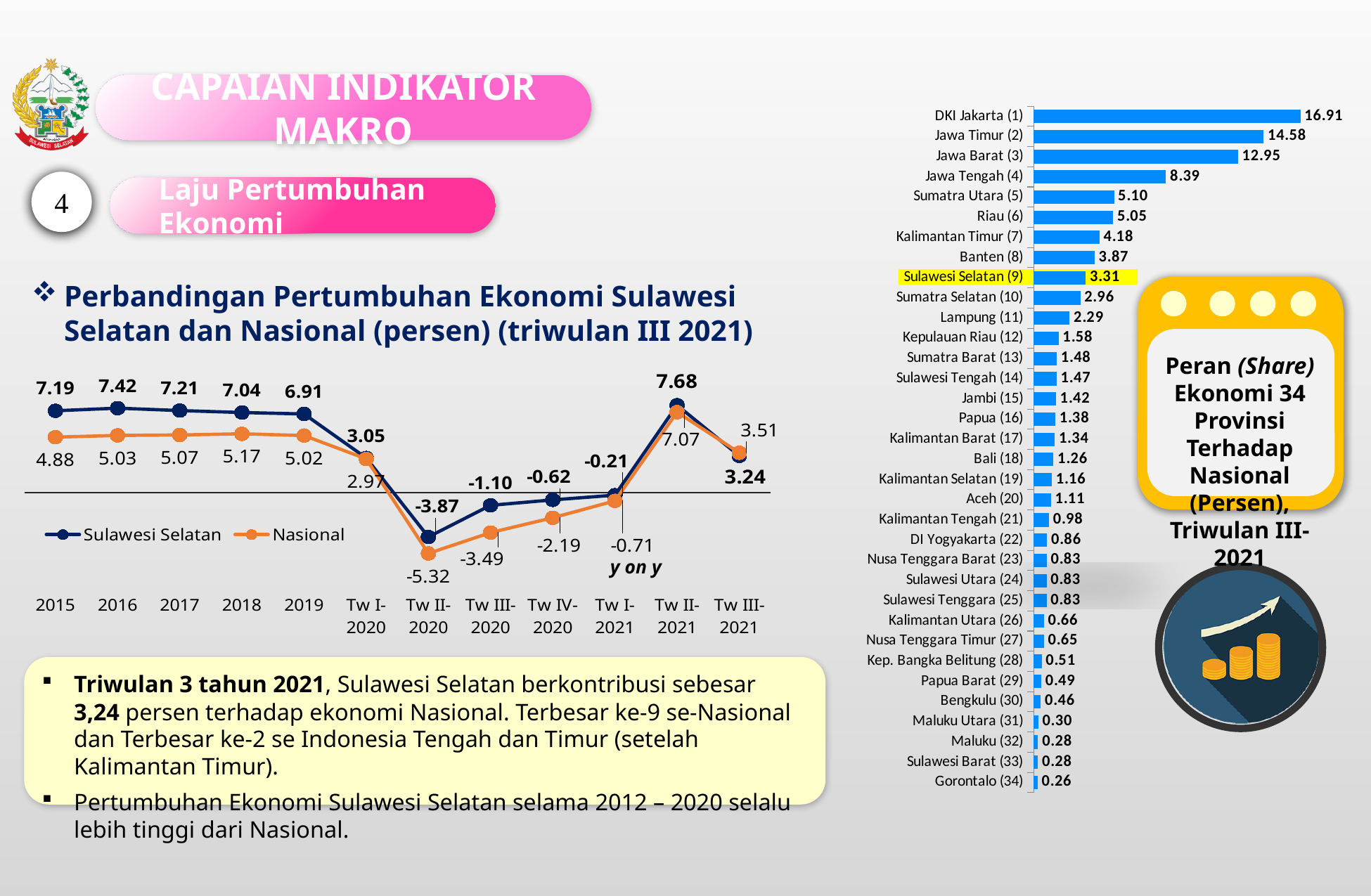
In the line chart on the left, how many series does the legend list? 2 In the line chart on the left, what is the difference between the Sulawesi Selatan and Nasional values in 2015? 2.31 In the bar chart on the right, what is the difference between the shares of Jawa Timur (2) and Jawa Barat (3)? 1.63 In the line chart on the left, which series had the higher value in Tw III-2021, Sulawesi Selatan or Nasional? Nasional In the line chart on the left, what was the value for Sulawesi Selatan in 2016? 7.42 In the bar chart on the right, which province has the lowest share? Gorontalo (34) In the line chart on the left, what was the Sulawesi Selatan value in Tw III-2021? 3.24 In the line chart on the left, in which period did Sulawesi Selatan reach its lowest value? Tw II-2020 In the bar chart on the right, which province has the highest share? DKI Jakarta (1) What type of chart is shown on the right side of the slide? Bar chart In the line chart on the left, what was the Nasional value in Tw II-2020? -5.32 In the bar chart on the right, what is the share for Sulawesi Selatan (9)? 3.31